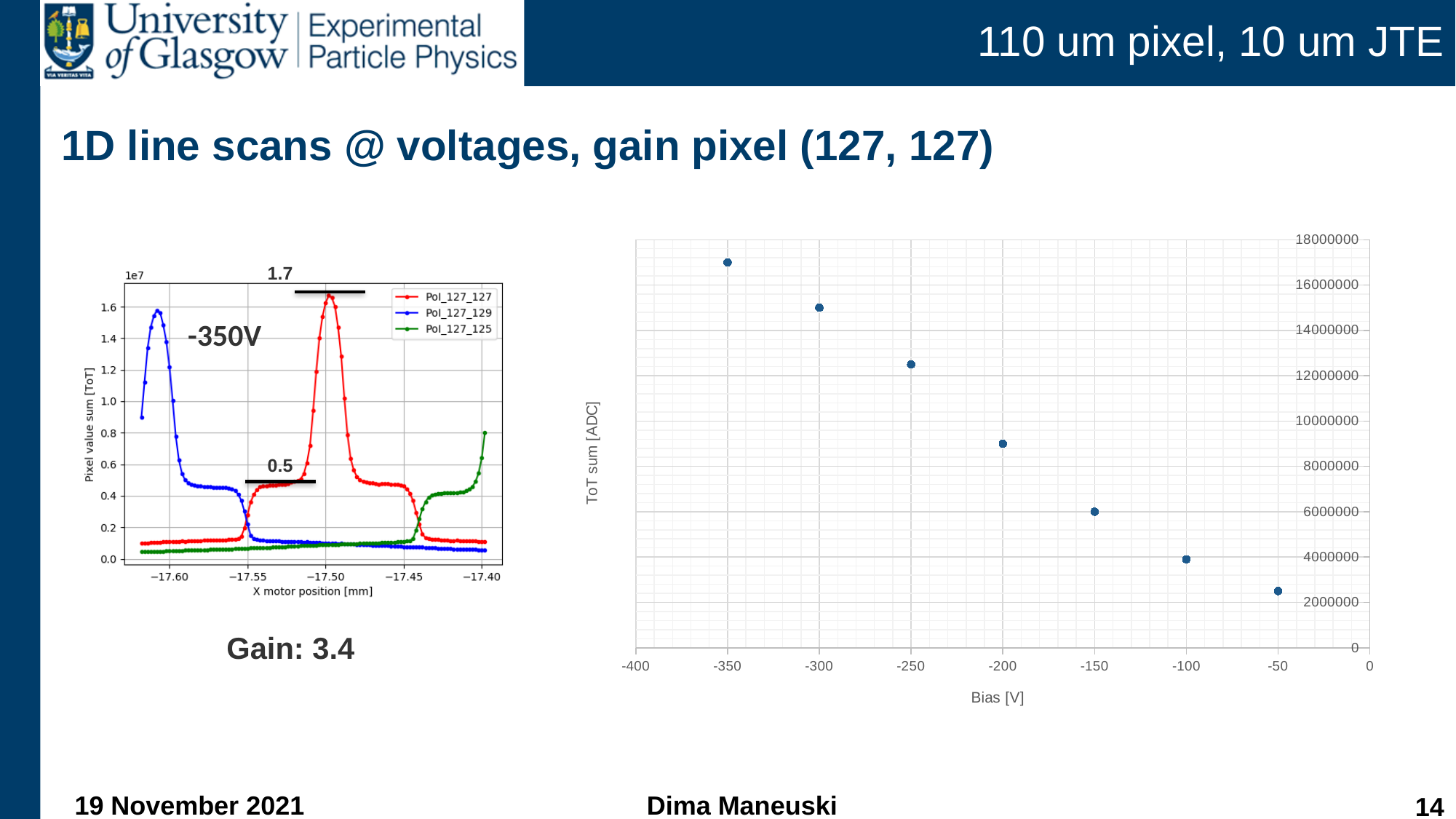
On the right chart, is the ToT sum at a bias of -300 V greater or less than 16000000? less What kind of chart is the left chart showing pixel value sum against X motor position? line chart On the left chart (1D line scans), which series reaches the highest peak? Pol_127_127 On the right chart, do the ToT sum values rise or fall as the bias goes from -350 V to -50 V along the x axis? fall On the left chart, what is the label of the x axis? X motor position [mm] On the right chart, is the ToT sum at a bias of -350 V greater or less than 16000000? greater On the right chart, is the ToT sum at a bias of -100 V greater or less than 6000000? less On the left chart (1D line scans), how many series does the legend list? 3 What kind of chart is the right chart showing ToT sum against Bias? scatter chart On the right chart (ToT sum vs Bias), how many data points are plotted? 7 On the right chart, which bias has the larger ToT sum, -350 V or -50 V? -350 V